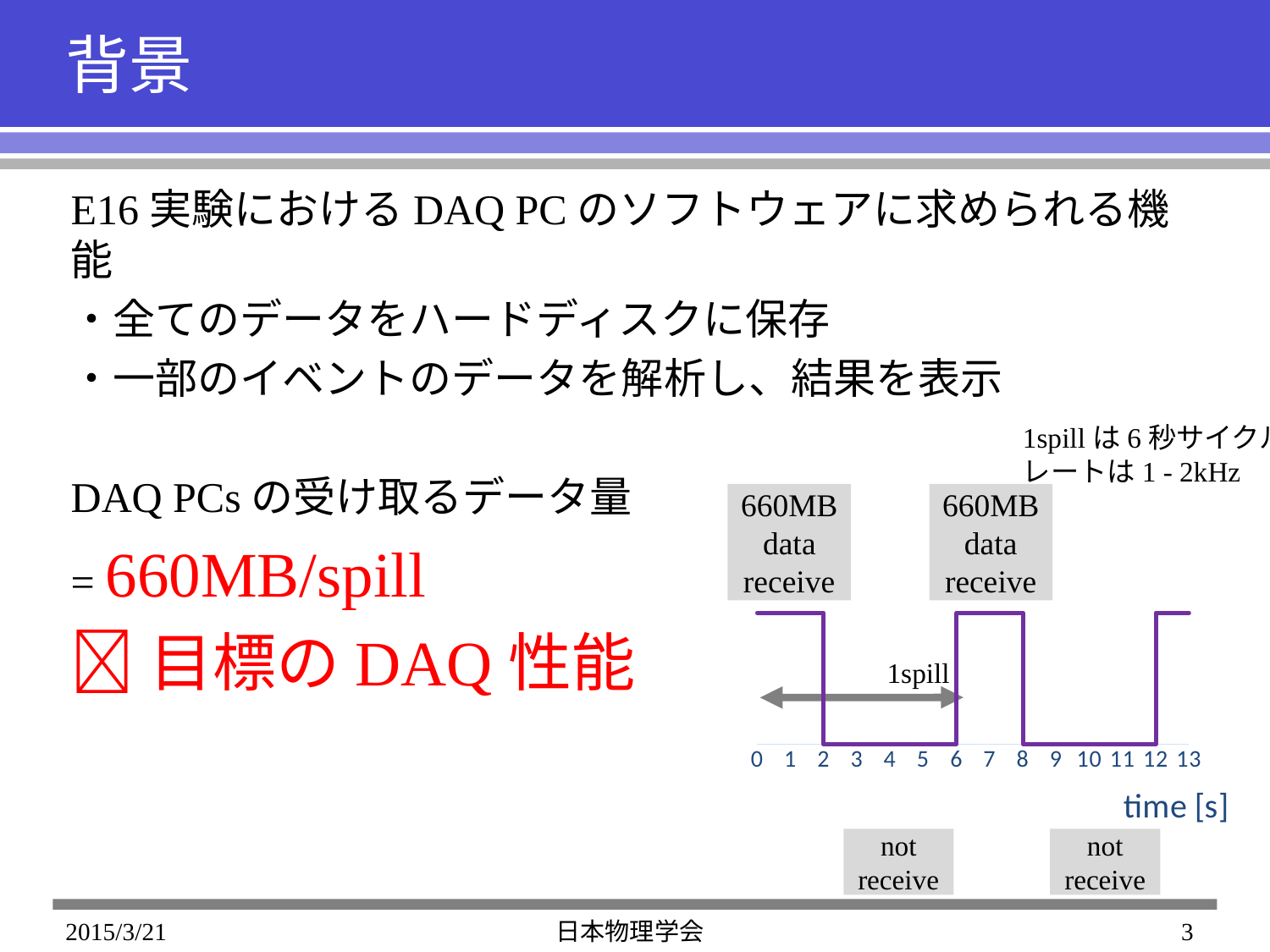
At what time in seconds does the first data receive period end in the timing chart? 2 What is the largest tick value shown on the x axis of the timing chart? 13 How many tick labels are shown on the x axis of the timing chart? 14 In the timing chart, is data being received at time 7 s? 660MB data receive According to the arrow in the timing chart, how many seconds long is 1spill? 6 At what time in seconds does the second data receive period begin in the timing chart? 6 At what time in seconds does the second data receive period end in the timing chart? 8 According to the timing chart, how much data is received in each receive period? 660MB How many '660MB data receive' labels are shown above the timing chart? 2 What is the label of the x axis of the timing chart? time [s] In the timing chart, is data being received at time 4 s? not receive How many 'not receive' labels are shown below the timing chart? 2